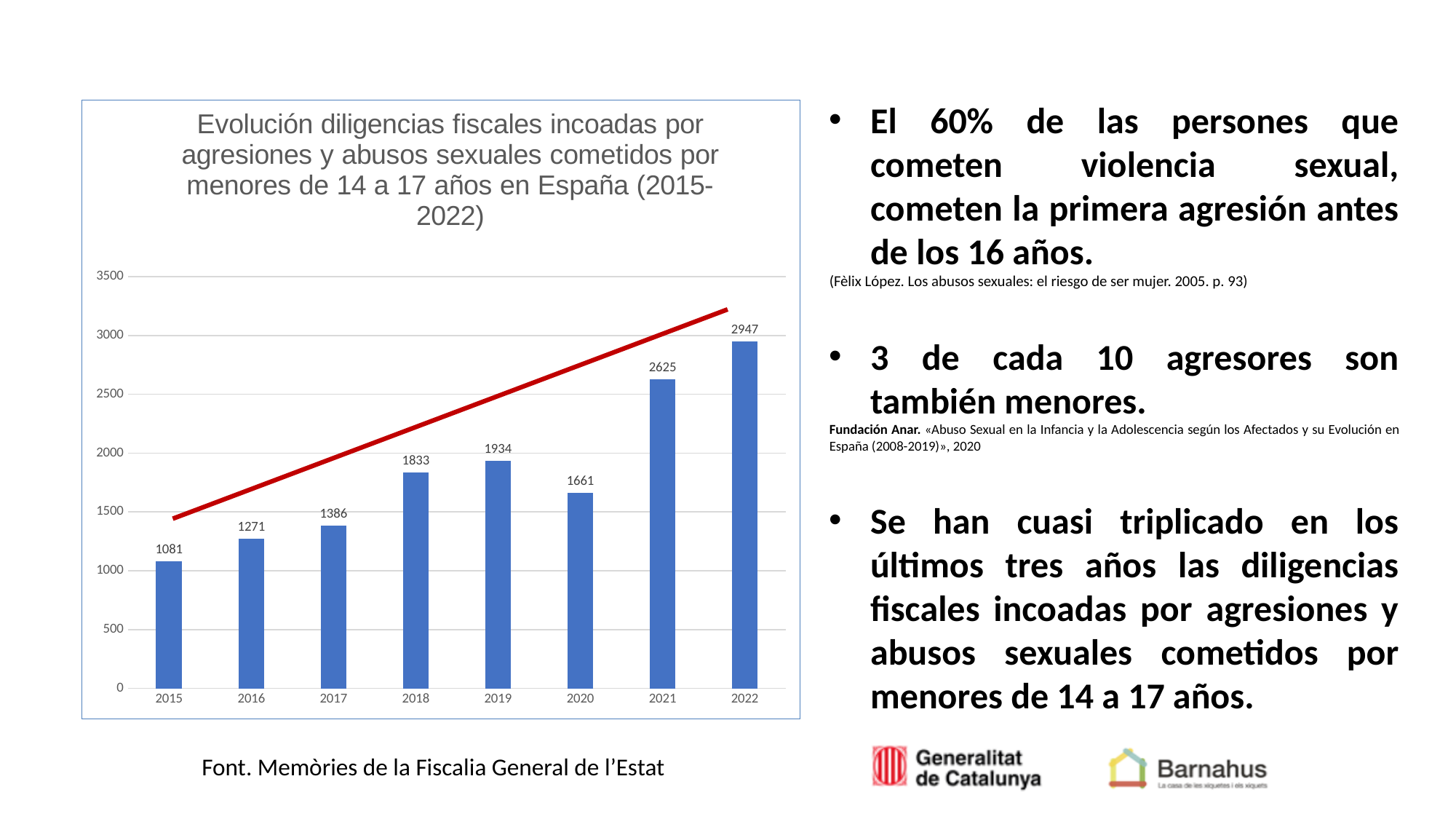
What is the value for 2022? 2947 What kind of chart is shown on the slide? bar chart What colour is the trend line drawn over the bars? red Which year has the lowest value? 2015 What is the value for 2015? 1081 What is the value for 2020? 1661 What is the difference between the values for 2022 and 2021? 322 What is the difference between the values for 2019 and 2020? 273 Is the value for 2021 greater or less than 2500? greater Which year has the highest value? 2022 How many years are shown on the x axis? 8 Which is larger, the value for 2018 or the value for 2020? 2018